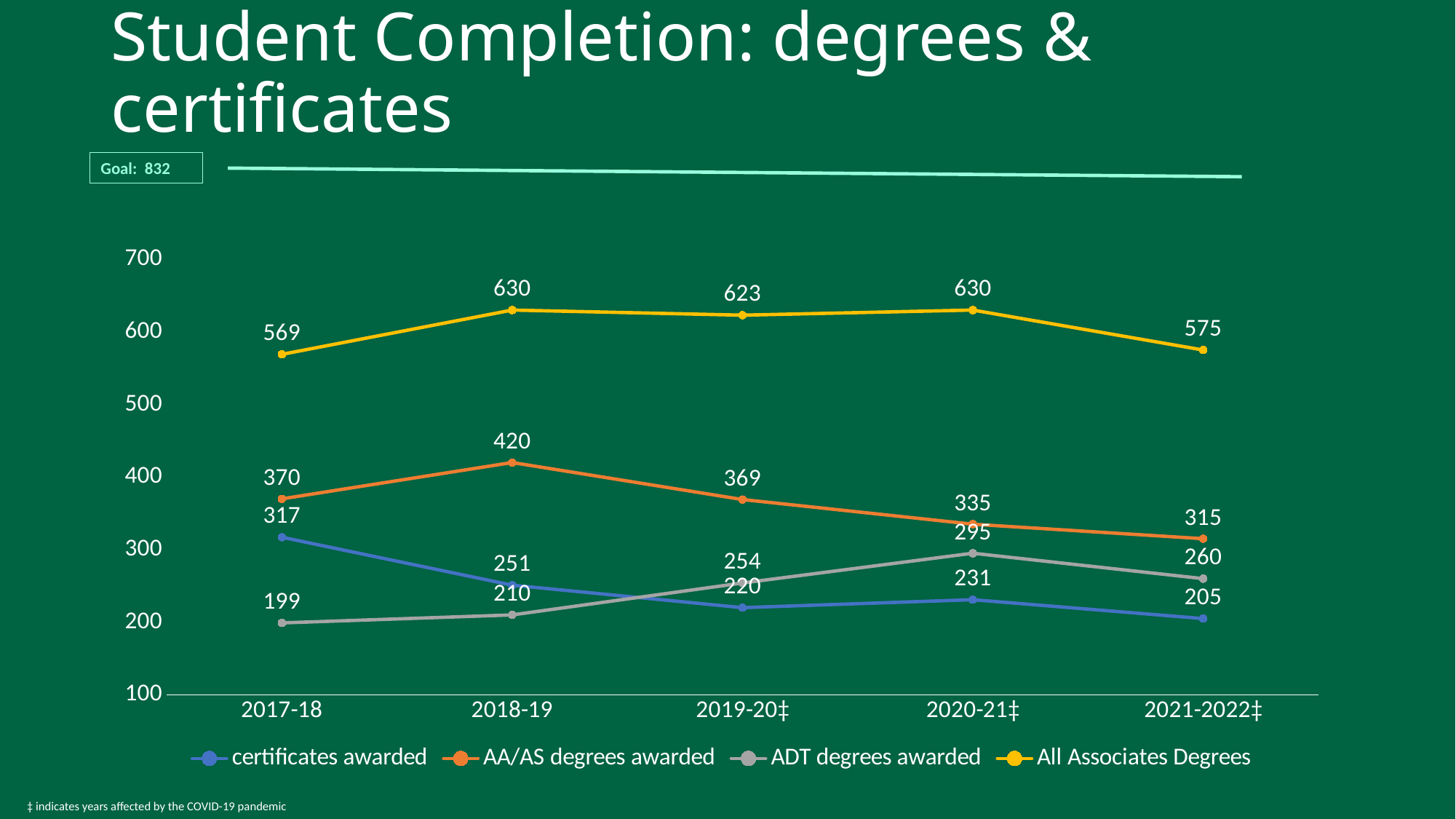
What goal value is shown in the box above the chart? 832 What is the value for All Associates Degrees in 2018-19? 630 In which year was the certificates awarded value lowest? 2021-2022‡ What is the difference between AA/AS degrees awarded in 2018-19 and in 2021-2022‡? 105 How many years are shown on the x axis? 5 In which year was the AA/AS degrees awarded value highest? 2018-19 How many certificates were awarded in 2017-18? 317 What is the value for ADT degrees awarded in 2020-21‡? 295 How many series does the legend list? 4 Which is larger in 2019-20‡: ADT degrees awarded or certificates awarded? ADT degrees awarded What is the value for AA/AS degrees awarded in 2021-2022‡? 315 What kind of chart is shown on the slide? Line chart